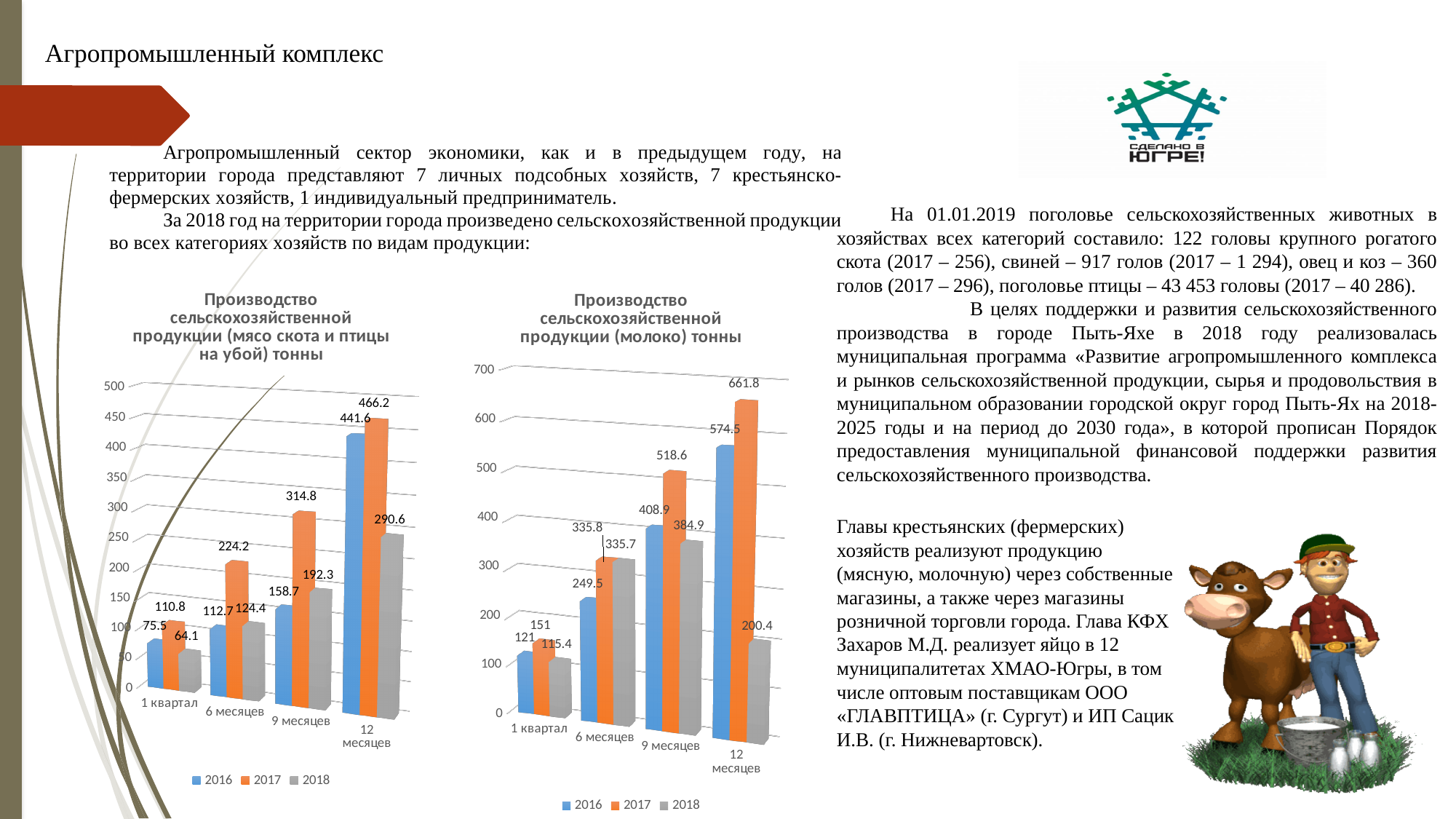
In the meat production chart (left), what is the value for 2018 at 1 квартал? 64.1 In the milk production chart (right), what is the value for 2018 at 12 месяцев? 200.4 In the milk production chart (right), which series has the highest value at 12 месяцев? 2017 In the meat production chart (left), which category has the lowest value for the 2018 series? 1 квартал In the meat production chart (left), what is the value for 2017 at 12 месяцев? 466.2 How many categories are shown on the x axis of the milk production chart (right)? 4 In the milk production chart (right), which is larger at 6 месяцев: the 2016 value or the 2017 value? 2017 In the milk production chart (right), what is the value for 2016 at 9 месяцев? 408.9 In the meat production chart (left), do the 2016 values rise or fall from 1 квартал to 12 месяцев? Rise In the meat production chart (left), what is the difference between the 2017 and 2016 values at 9 месяцев? 156.1 How many series does the legend of the meat production chart (left) list? 3 What kind of chart is the milk production chart (right)? Bar chart